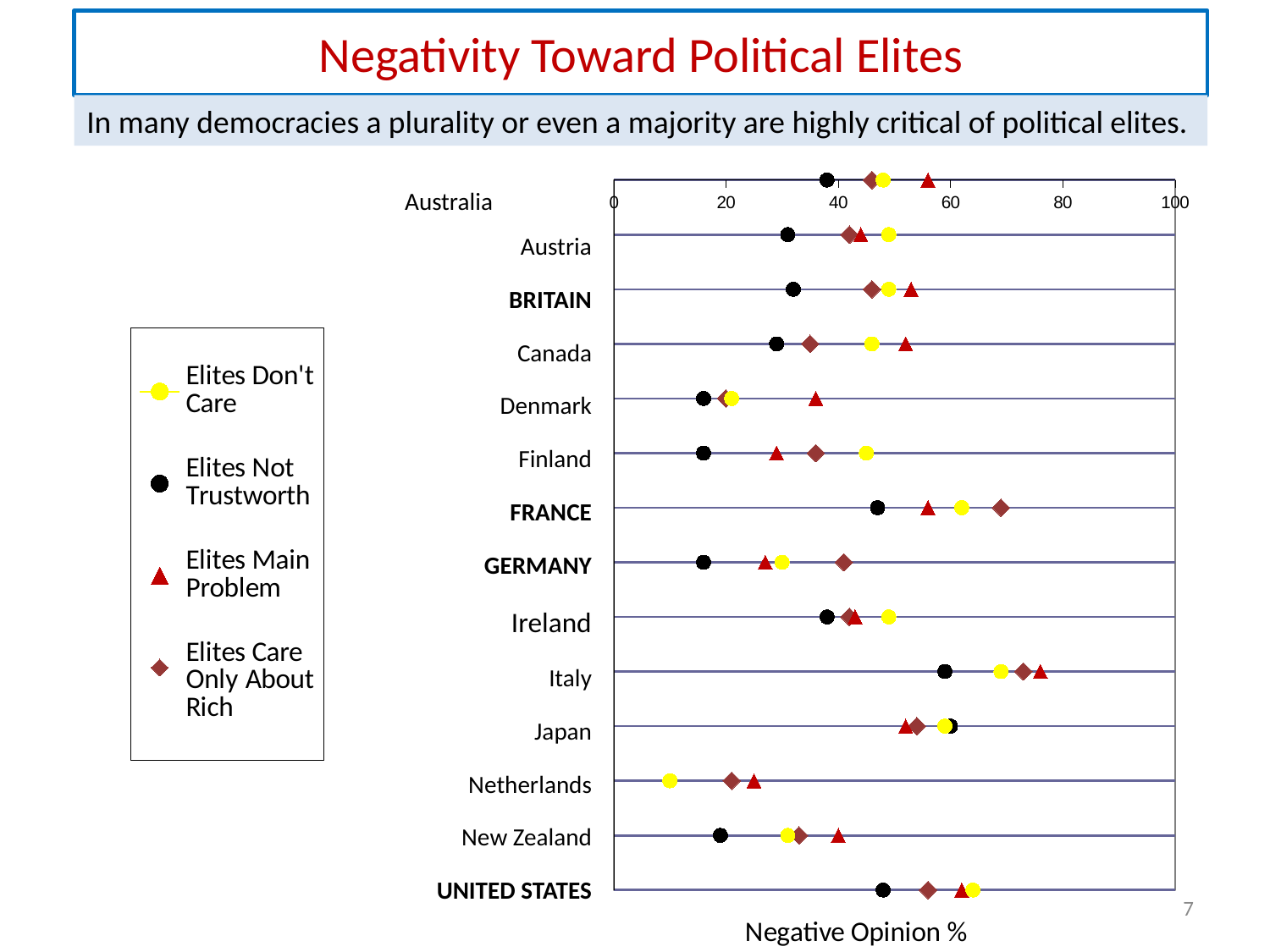
Which is larger: the 'Elites Care Only About Rich' value for France or for Germany? France Is the 'Elites Main Problem' value for Italy greater or less than 60? greater Is the 'Elites Don't Care' value for Netherlands greater or less than 20? less Which country has the lowest value for 'Elites Don't Care'? Netherlands Is the 'Elites Not Trustworth' value for Denmark greater or less than 20? less How many series does the legend list? 4 What is the label of the x axis? Negative Opinion % Which is larger: the 'Elites Not Trustworth' value for Italy or for Canada? Italy How many countries are listed on the chart? 14 Which country has the highest value for 'Elites Care Only About Rich'? Italy Which country has the highest value for 'Elites Main Problem'? Italy What kind of chart is shown on the slide? Dot plot (scatter chart)